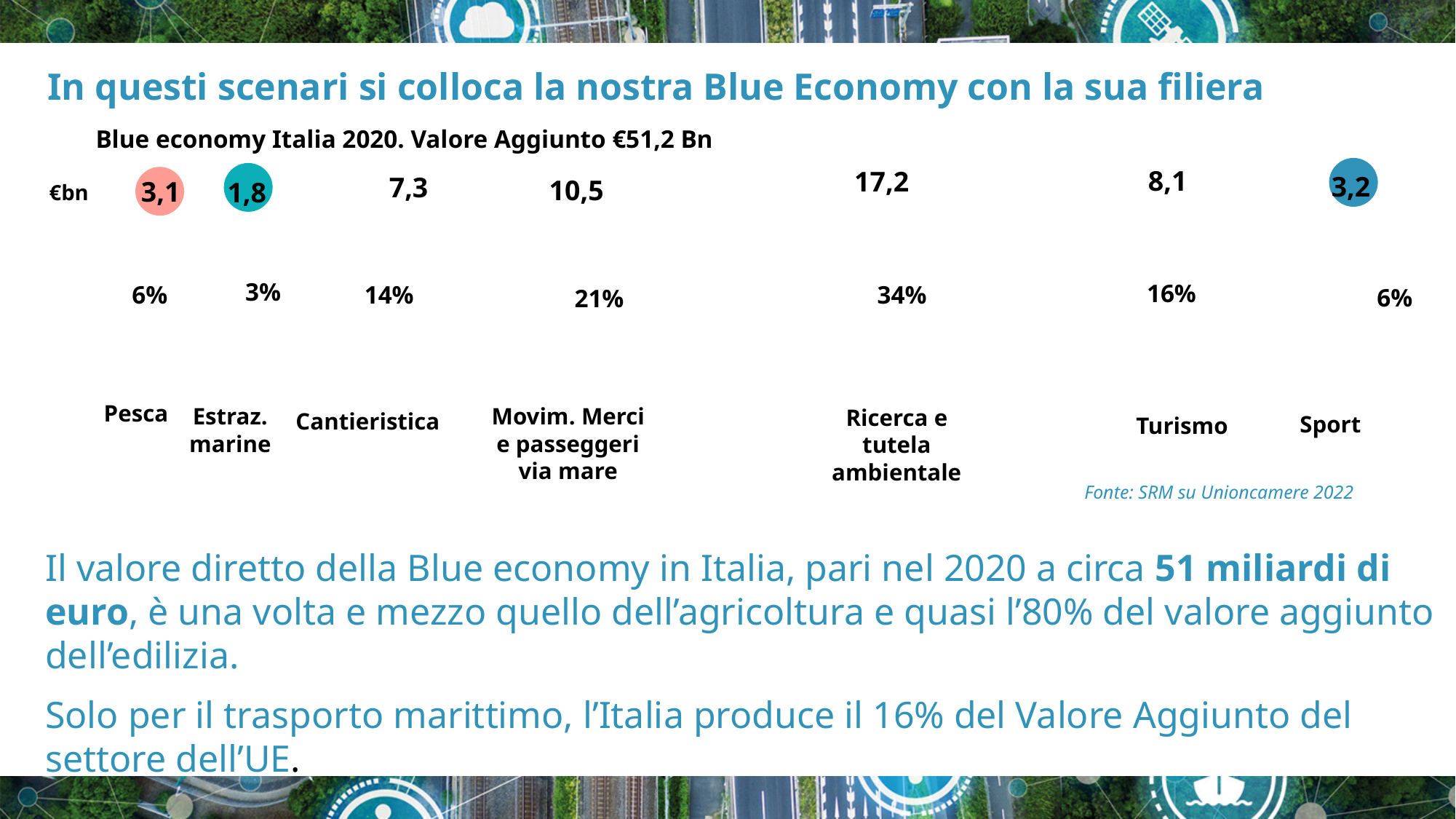
What is the value added in €bn for Turismo? 8,1 What is the title of the chart? Blue economy Italia 2020. Valore Aggiunto €51,2 Bn What is the difference in €bn between Ricerca e tutela ambientale and Turismo? 9,1 What source is cited for the chart? SRM su Unioncamere 2022 What is the value in €bn for Estraz. marine? 1,8 Which sector has the lowest value added? Estraz. marine What is the difference in €bn between Cantieristica and Pesca? 4,2 Which has a larger value added, Sport or Pesca? Sport What percentage share is shown for Movim. Merci e passeggeri via mare? 21% Which sector has the highest value added? Ricerca e tutela ambientale What is the value added in €bn for Ricerca e tutela ambientale? 17,2 How many sectors are shown in the chart? 7